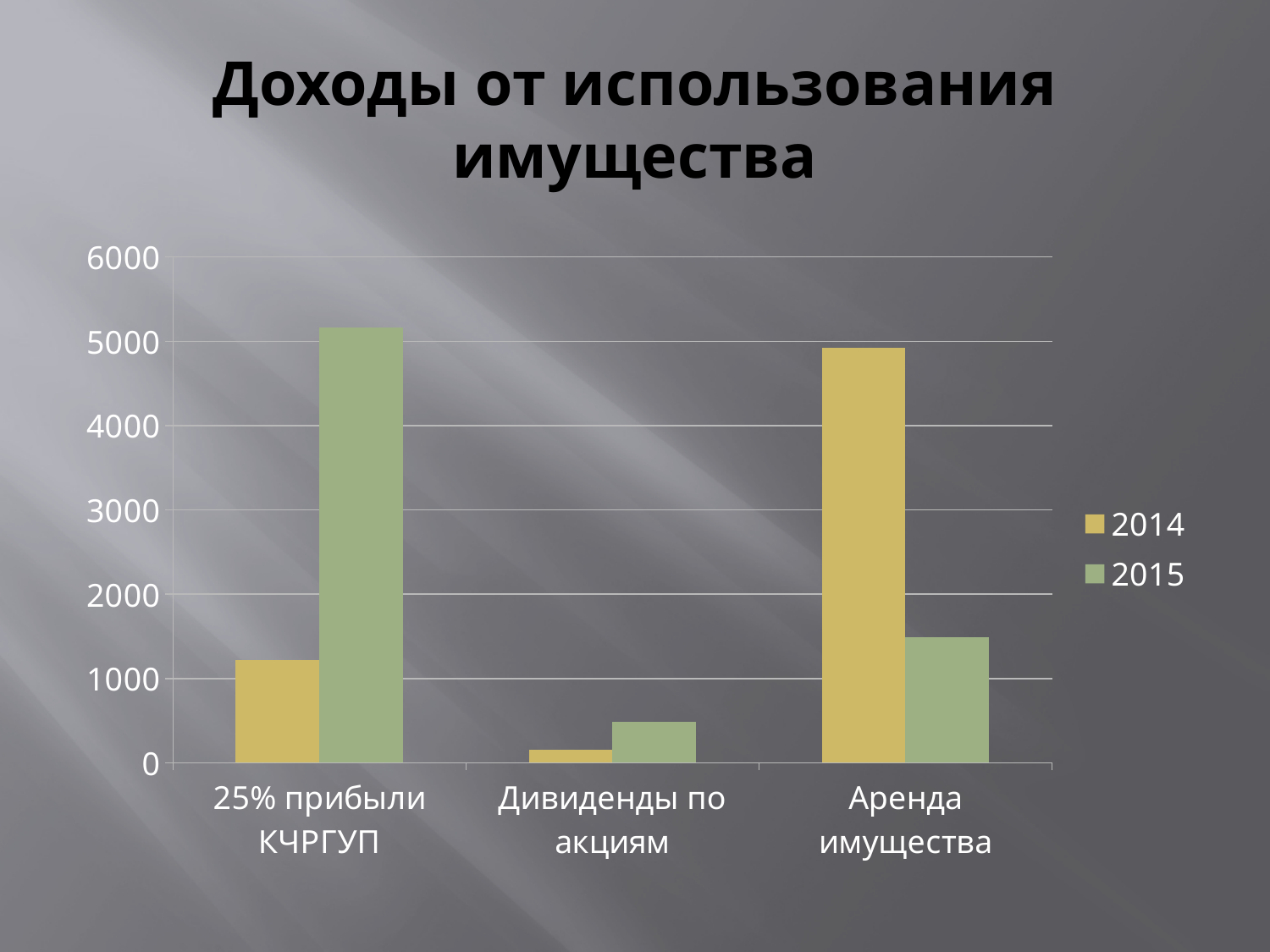
Is the 2014 value for Аренда имущества greater or less than 4000? greater Which category has the highest value for 2015? 25% прибыли КЧРГУП How many categories are shown on the x axis? 3 Which category has the lowest value for 2014? Дивиденды по акциям What kind of chart is shown on the slide? bar chart How many series does the legend list? 2 What is the title of the chart? Доходы от использования имущества For 25% прибыли КЧРГУП, which year has the larger value, 2014 or 2015? 2015 For Аренда имущества, which year has the larger value, 2014 or 2015? 2014 Is the 2015 value for 25% прибыли КЧРГУП greater or less than 5000? greater Which category has the highest value for 2014? Аренда имущества Is the 2015 value for Дивиденды по акциям greater or less than 1000? less